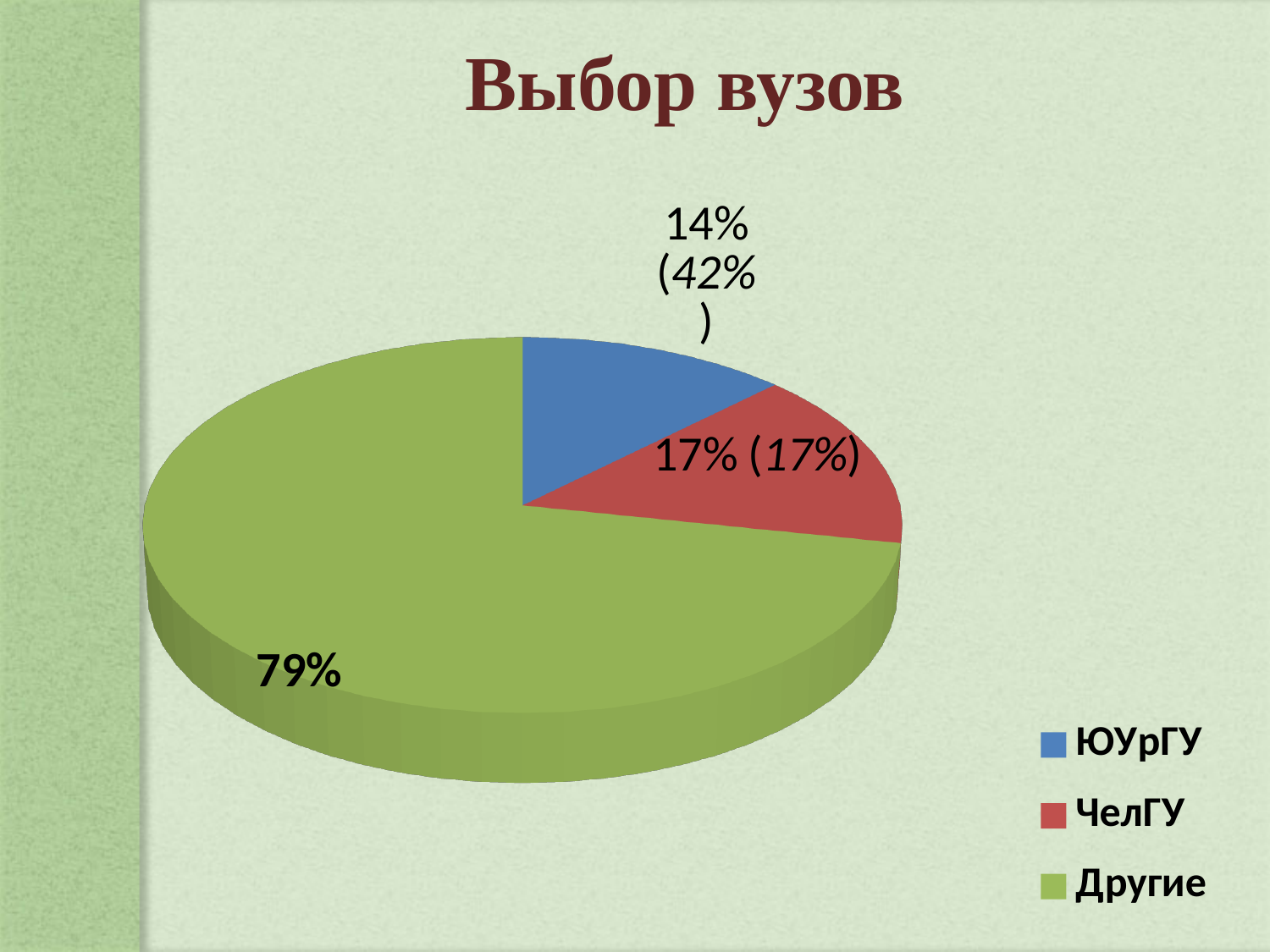
What percentage is shown for the Другие slice? 79% What kind of chart is shown on the slide? pie chart What is the title of the chart? Выбор вузов Which category has the smallest share of the pie? ЮУрГУ What data label is printed on the ЧелГУ slice? 17% (17%) What colour is the Другие slice? green Which category has the largest share of the pie? Другие By how many percentage points does the Другие slice exceed the ЧелГУ slice, using the first percentage shown on each label? 62% How many entries does the legend list? 3 Which slice is larger, ЧелГУ or ЮУрГУ? ЧелГУ What data label is printed for the ЮУрГУ slice? 14% (42%) How many slices does the pie chart have? 3